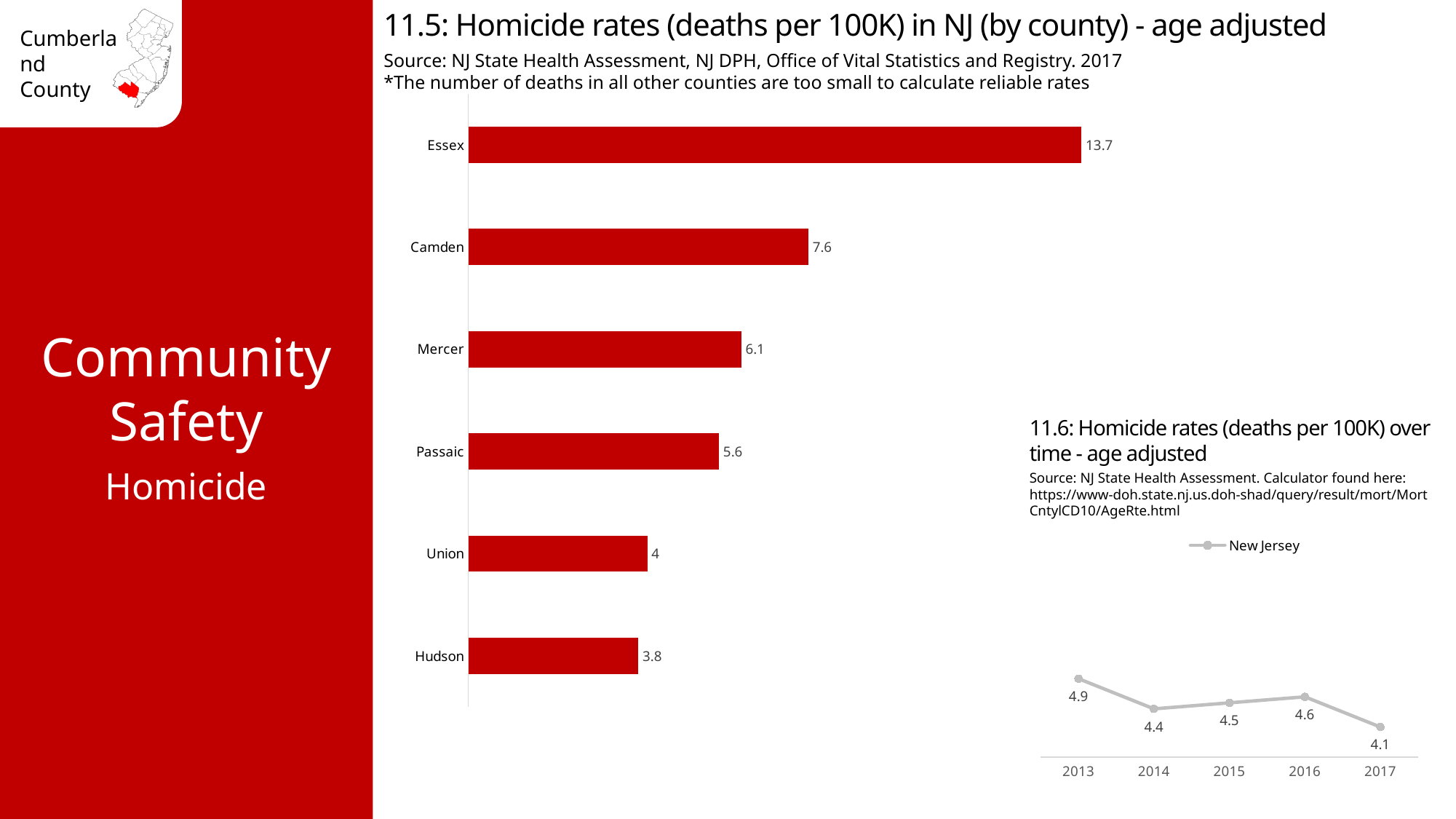
What kind of chart is '11.5: Homicide rates (deaths per 100K) in NJ (by county) - age adjusted'? Bar chart In the chart '11.6: Homicide rates (deaths per 100K) over time - age adjusted', which year has the lowest homicide rate? 2017 In the chart '11.5: Homicide rates (deaths per 100K) in NJ (by county) - age adjusted', which county has the lowest homicide rate? Hudson In the chart '11.6: Homicide rates (deaths per 100K) over time - age adjusted', what was the New Jersey homicide rate in 2013? 4.9 How many series does the legend list in the chart '11.6: Homicide rates (deaths per 100K) over time - age adjusted'? 1 In the chart '11.6: Homicide rates (deaths per 100K) over time - age adjusted', what is the difference between the 2013 and 2017 rates? 0.8 In the chart '11.5: Homicide rates (deaths per 100K) in NJ (by county) - age adjusted', which county has a higher rate, Union or Hudson? Union In the chart '11.5: Homicide rates (deaths per 100K) in NJ (by county) - age adjusted', what is the homicide rate for Passaic? 5.6 How many counties are shown in the chart '11.5: Homicide rates (deaths per 100K) in NJ (by county) - age adjusted'? 6 In the chart '11.5: Homicide rates (deaths per 100K) in NJ (by county) - age adjusted', which county has the highest homicide rate? Essex In the chart '11.5: Homicide rates (deaths per 100K) in NJ (by county) - age adjusted', what is the homicide rate for Essex? 13.7 In the chart '11.5: Homicide rates (deaths per 100K) in NJ (by county) - age adjusted', what is the difference between the rates for Camden and Mercer? 1.5